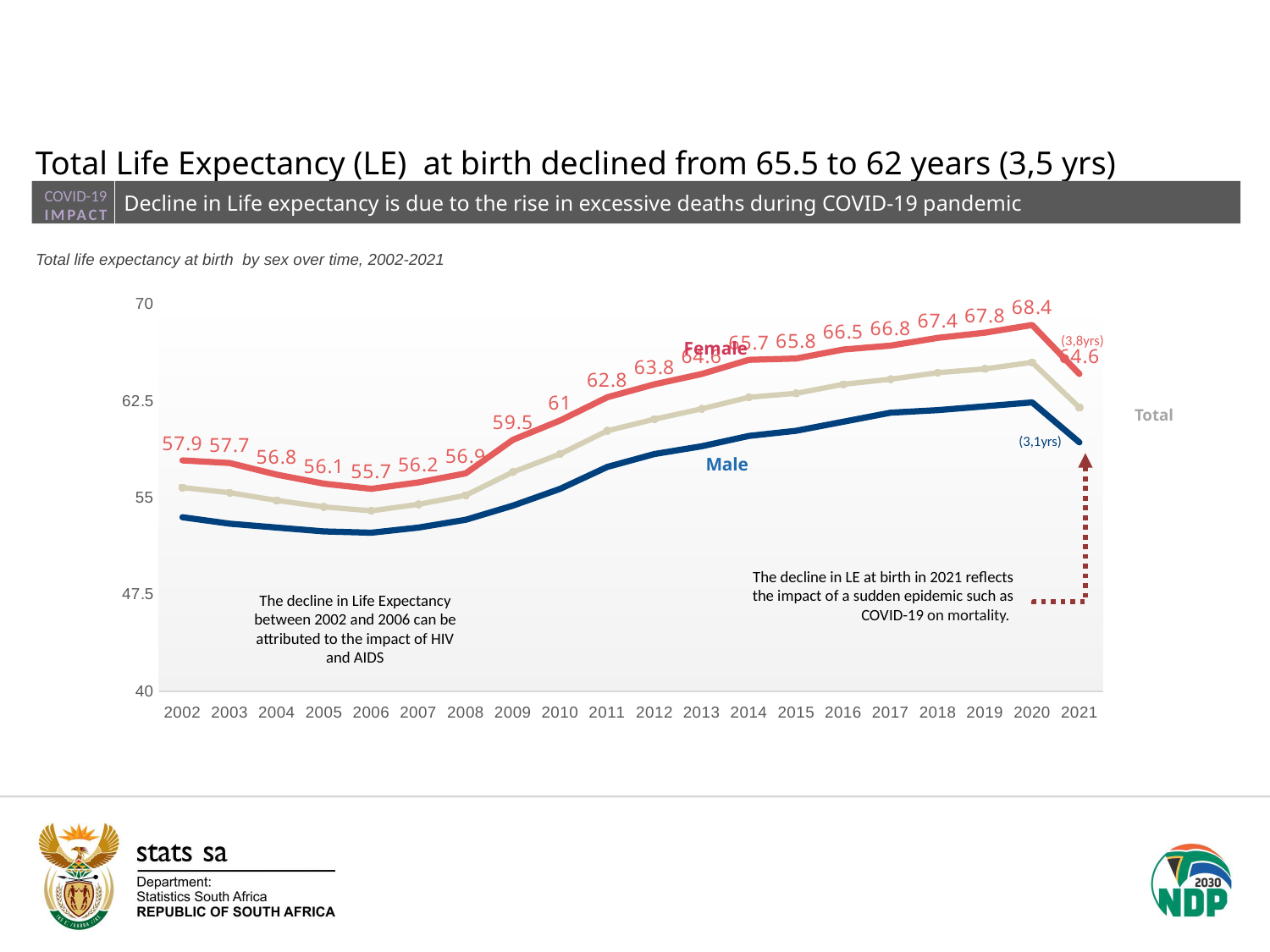
In which year is the Female life expectancy highest? 2020 What is the difference between the Female life expectancy in 2002 and in 2006? 2.2 In which year is the Female life expectancy lowest? 2006 By how much did the Female life expectancy change from 2019 to 2020? 0.6 Is the Male life expectancy value for 2002 greater or less than 55? less Is the Female life expectancy higher in 2010 or in 2011? 2011 What kind of chart is shown on the slide? line chart How many series (lines) are plotted on the chart? 3 What is the Female life expectancy value for 2002? 57.9 How many years are plotted along the x axis of the chart? 20 Which series is drawn with the dark blue line? Male What is the Female life expectancy value for 2020? 68.4